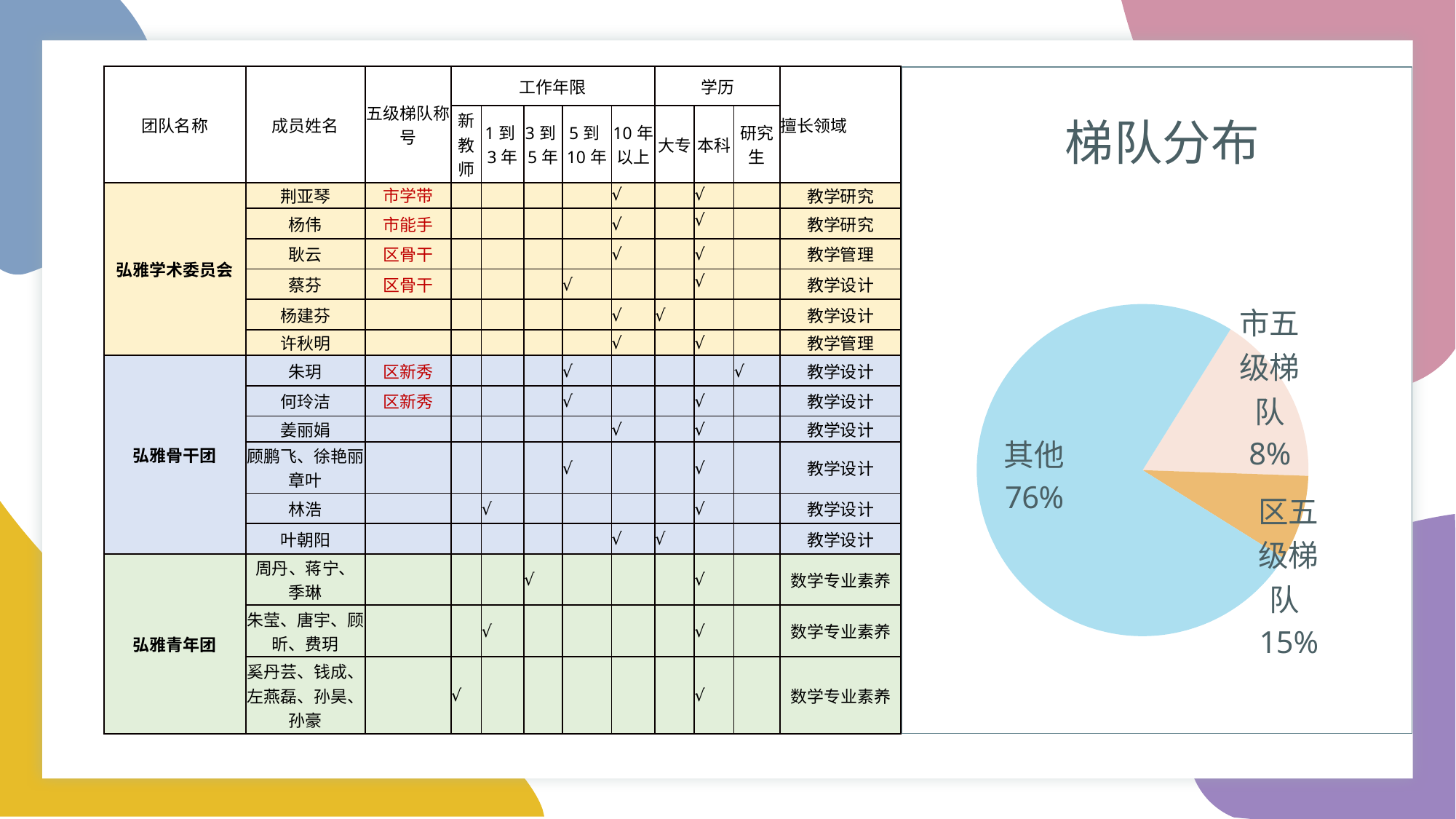
In the pie chart, what share does 其他 have? 76% What kind of chart is shown on the right side of the slide? pie chart In the pie chart, what share does 区五级梯队 have? 15% In the pie chart, what share does 市五级梯队 have? 8% What is the title of the pie chart? 梯队分布 In the pie chart, what is the difference in percentage points between 区五级梯队 and 市五级梯队? 7 Which slice of the pie chart is the largest? 其他 In the pie chart, what is the difference in percentage points between 其他 and 区五级梯队? 61 What colour is the 其他 slice in the pie chart? light blue How many slices does the pie chart have? 3